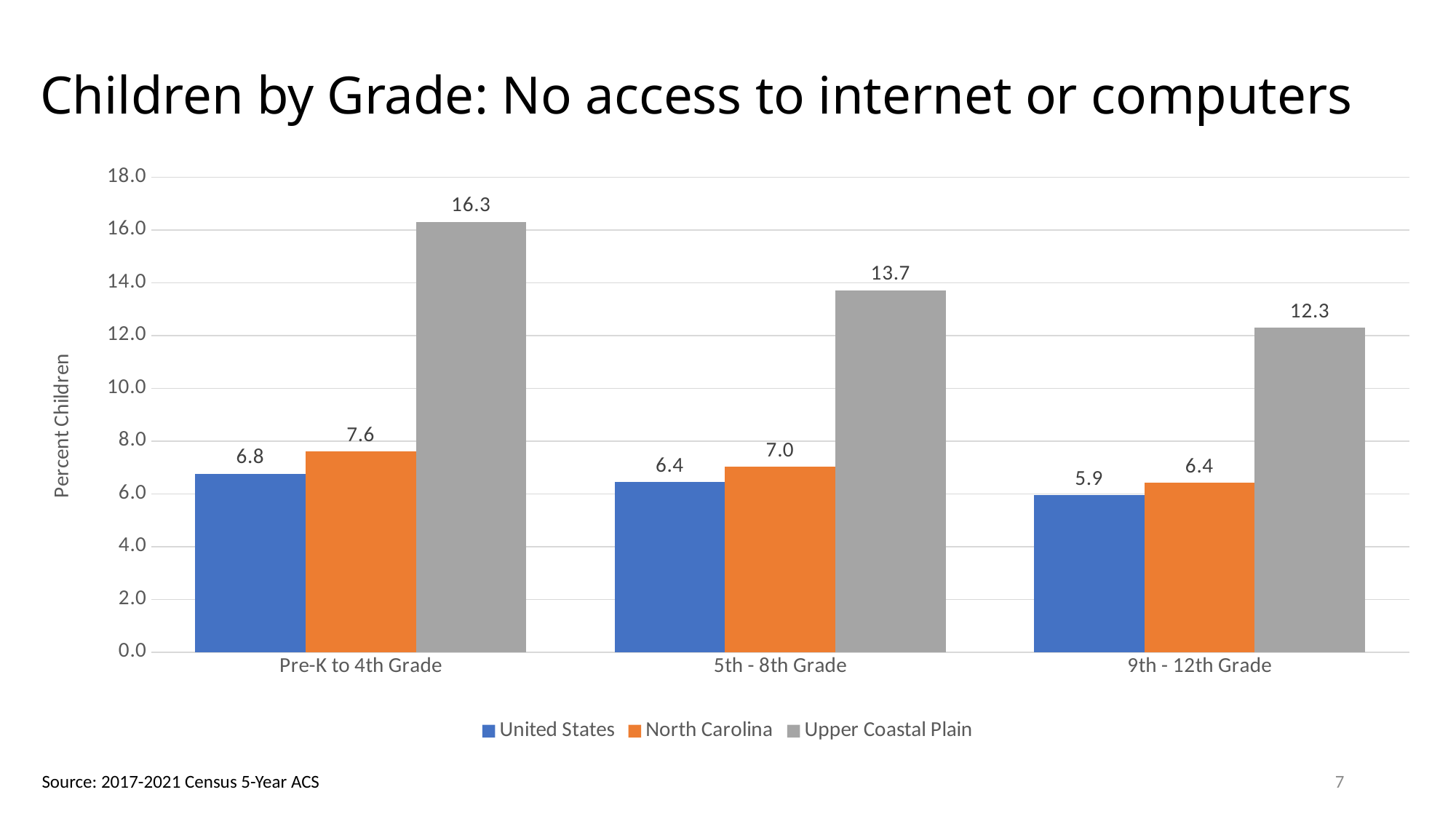
How many series does the legend list? 3 What is the difference between the Upper Coastal Plain and United States values for Pre-K to 4th Grade? 9.5 How many grade categories are shown on the x axis? 3 What is the value for Upper Coastal Plain in the Pre-K to 4th Grade category? 16.3 What kind of chart is shown on the slide? Bar chart Which is larger in the 5th - 8th Grade category: the United States value or the North Carolina value? North Carolina What is the difference between the North Carolina values for Pre-K to 4th Grade and 9th - 12th Grade? 1.2 Which grade category has the lowest value for United States? 9th - 12th Grade Which grade category has the highest value for Upper Coastal Plain? Pre-K to 4th Grade What is the value for United States in the 9th - 12th Grade category? 5.9 Is the value for Upper Coastal Plain in the 9th - 12th Grade category greater or less than 10.0? greater What is the value for North Carolina in the 5th - 8th Grade category? 7.0